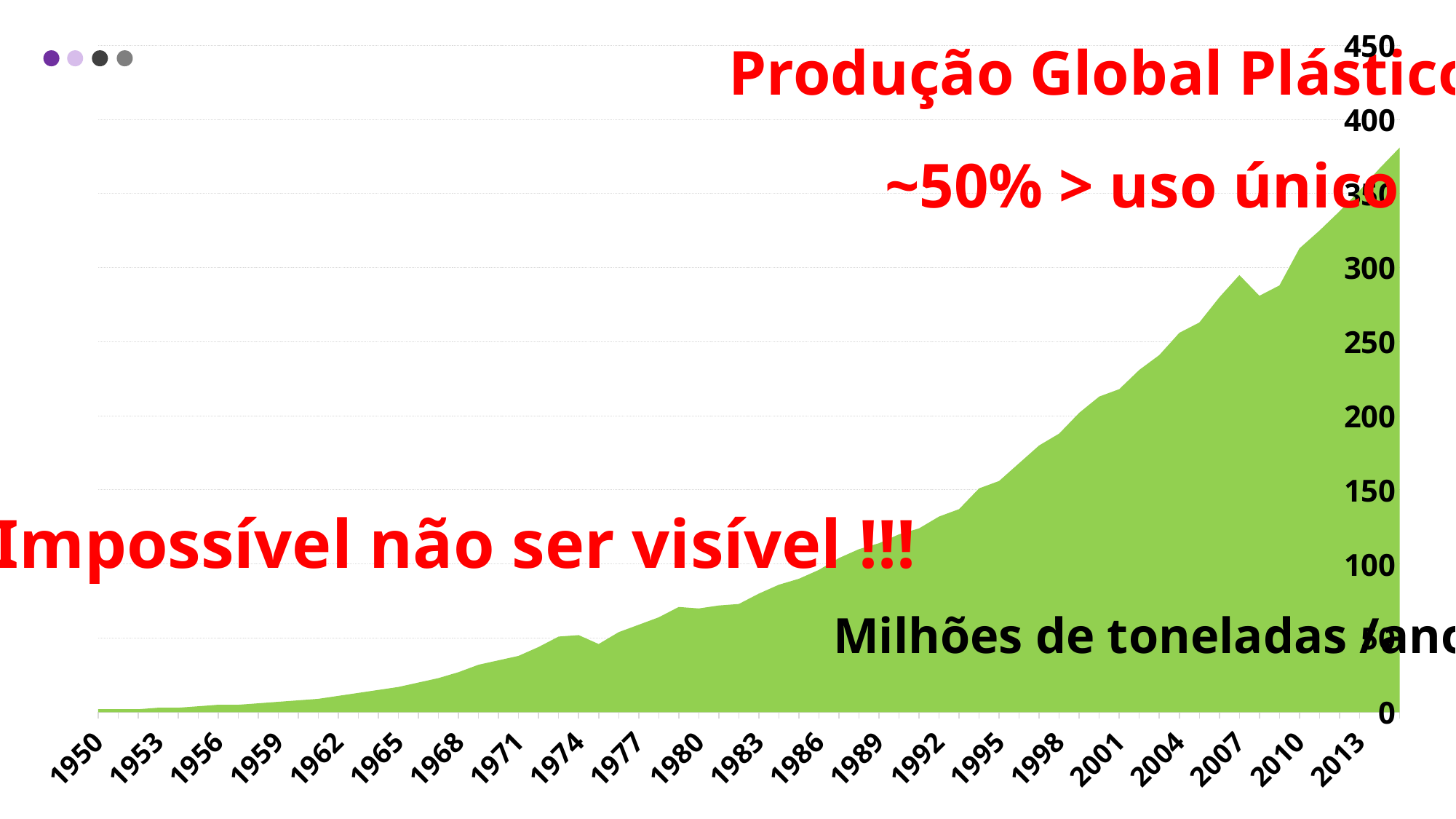
Is the value for 2007 greater or less than 250? greater Which has the larger value, 2001 or 2013? 2013 Do the values rise or fall overall from 1950 to 2013? rise Which labelled year on the x axis has the lowest value? 1950 How many year labels are shown on the x axis? 22 What is the title of the chart? Produção Global Plástico Is the value for 1965 greater or less than 50? less What unit is the chart's vertical axis measured in, according to the label on the slide? Milhões de toneladas /ano Is the value for 1992 greater or less than 100? greater What kind of chart is shown on the slide? area chart